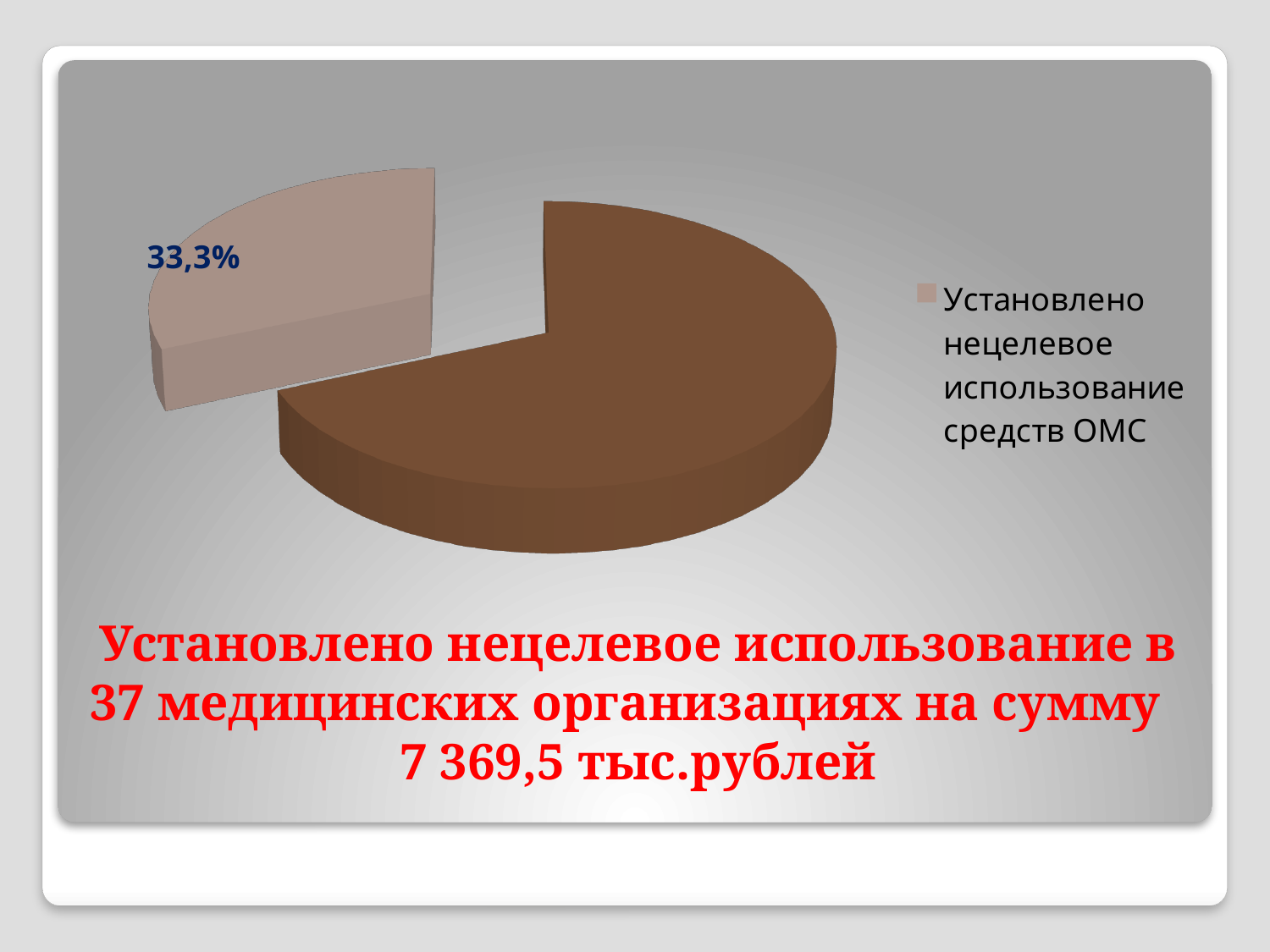
Which slice is larger, the brown slice or the light-coloured slice labelled 33,3%? the brown slice How many slices does the pie chart have? 2 What is the legend entry shown next to the pie chart? Установлено нецелевое использование средств ОМС What colour is the slice labelled 33,3%? light pink How many entries does the legend list? 1 What kind of chart is shown on the slide? pie chart What share of the pie is labelled on the exploded light-coloured slice? 33,3%